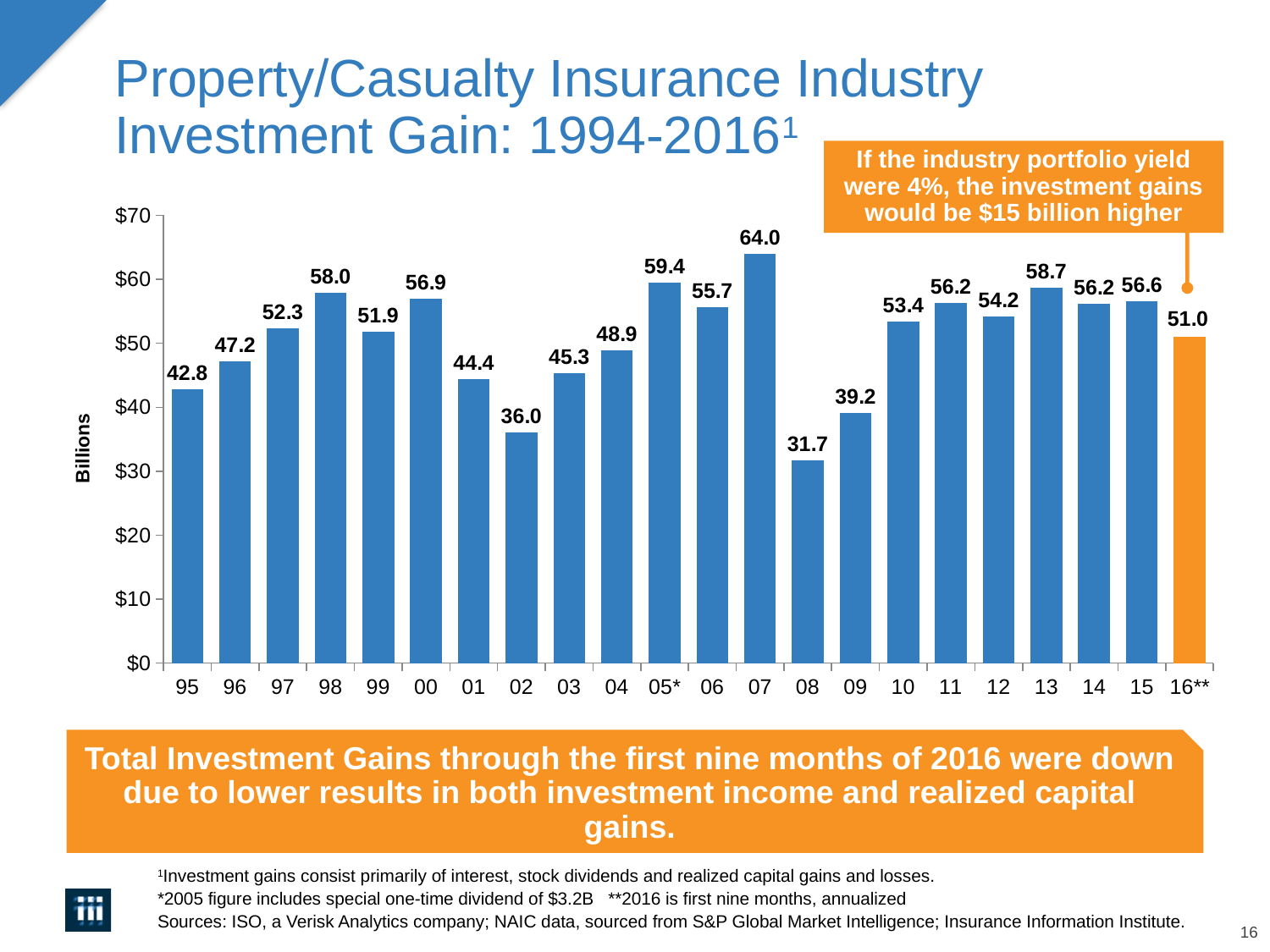
Which bar on the chart is coloured orange instead of blue? 16** What is the value shown for 2002? 36.0 Which year has the lowest investment gain on the chart? 08 What is the label on the vertical axis of the chart? Billions What kind of chart is shown on the slide? Bar chart Do the values rise or fall from 2008 to 2010? Rise What is the value shown for the 2016** bar? 51.0 Which is larger, the value for 2013 or the value for 2014? 2013 How many bars are plotted on the chart? 22 What is the difference between the 2007 value and the 2008 value? 32.3 Which year has the highest investment gain on the chart? 07 What is the investment gain value shown for 2007? 64.0